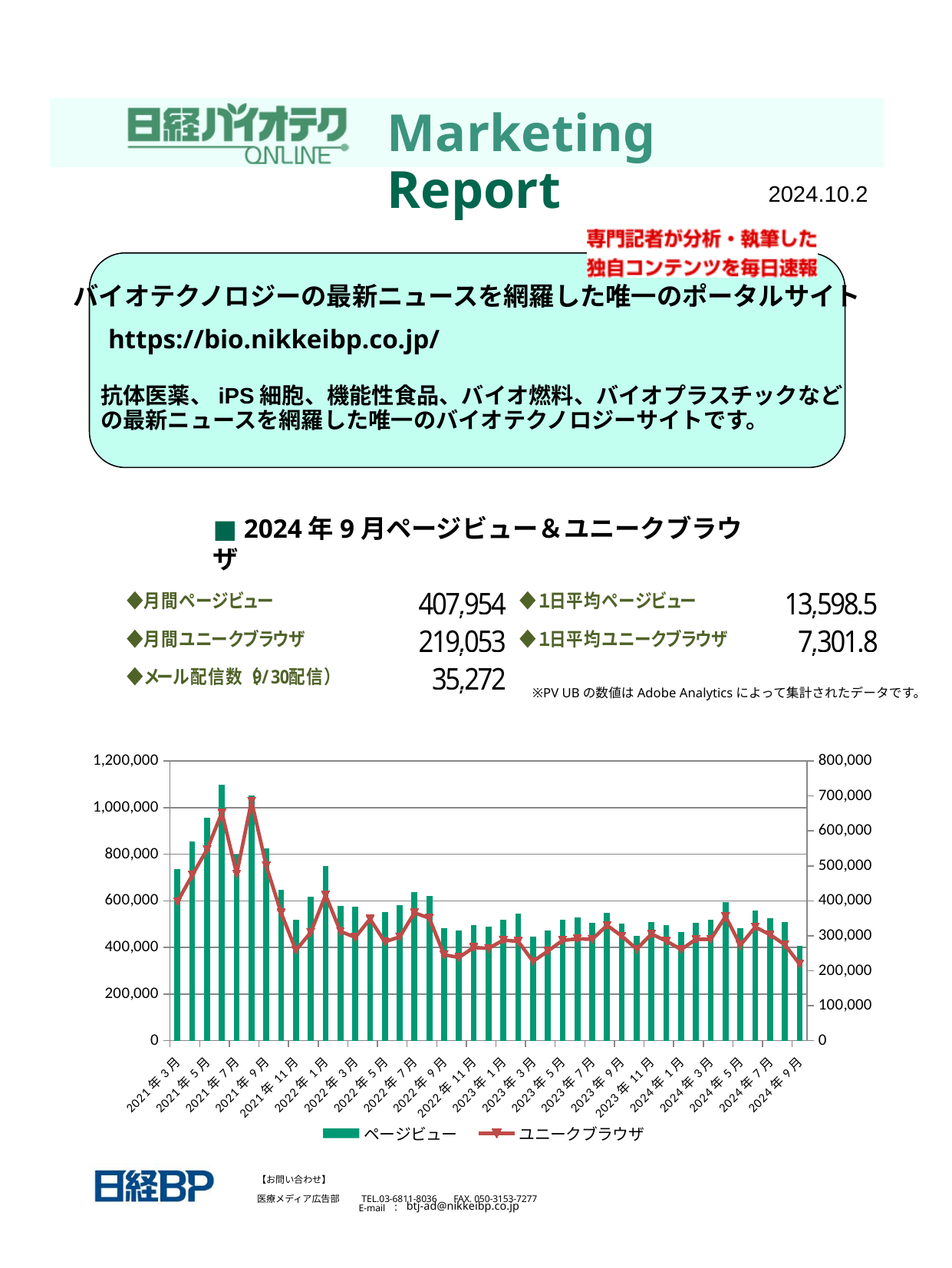
Overall, do the page view (ページビュー) bars rise or fall from 2021年3月 to 2024年9月? fall Which month has the larger page view (ページビュー) bar, 2021年3月 or 2024年9月? 2021年3月 What is the maximum value shown on the left vertical axis of the chart? 1,200,000 How many series does the chart legend list? 2 Is the page view (ページビュー) value for 2021年3月 greater or less than 600,000? greater What kind of chart is shown at the bottom of the slide? A combination bar and line chart What are the two legend entries of the chart? ページビュー and ユニークブラウザ According to the slide, what is the monthly page view (月間ページビュー) value for September 2024, the last bar in the chart? 407,954 How many month labels are shown on the x axis of the chart? 22 Which series is drawn as bars in the chart? ページビュー Is the unique browser (ユニークブラウザ) value for 2024年9月 greater or less than 300,000 on the right axis? less Is the page view (ページビュー) value for 2024年9月 greater or less than 600,000? less